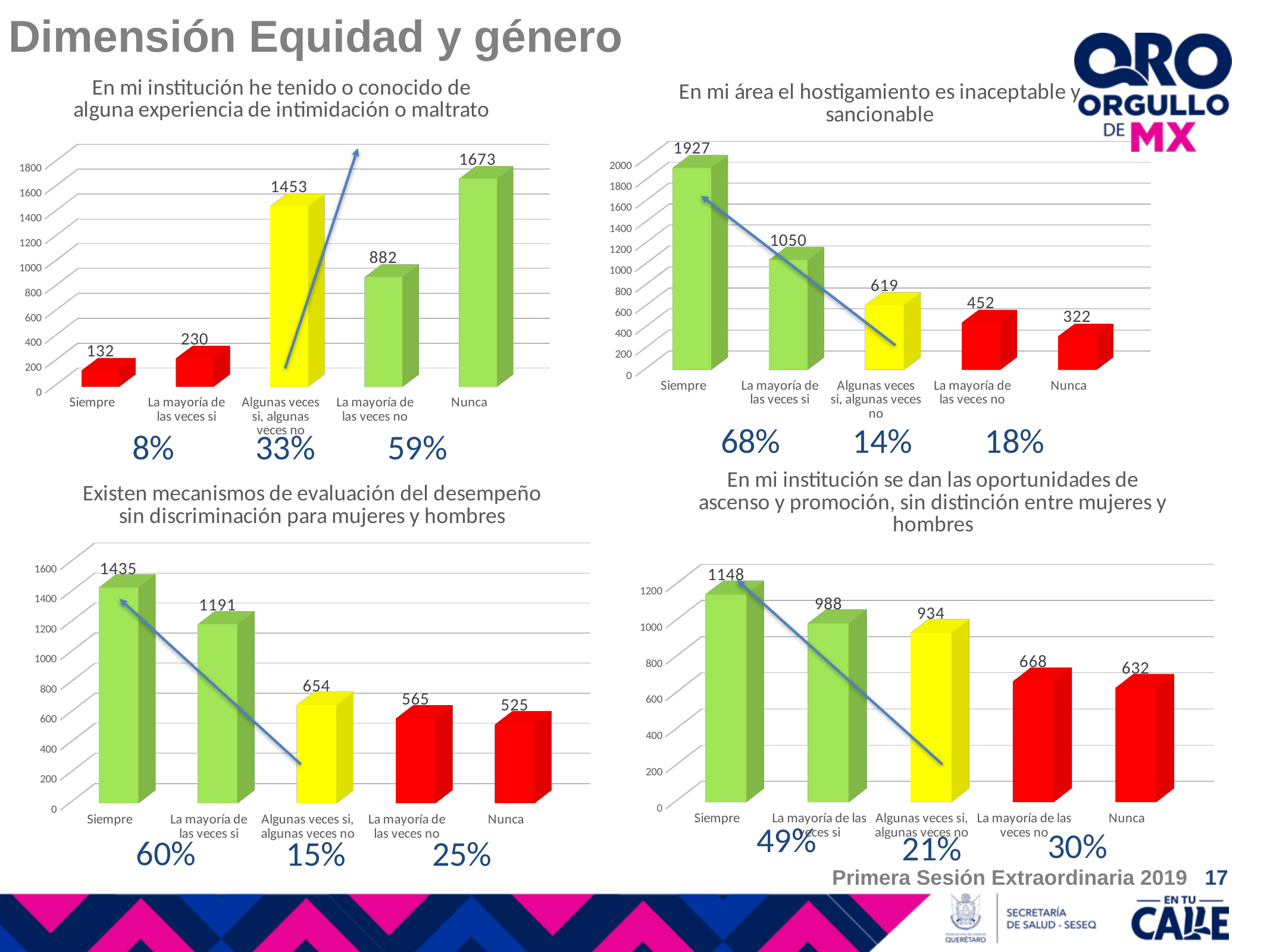
What kind of chart is the one titled 'En mi institución se dan las oportunidades de ascenso y promoción, sin distinción entre mujeres y hombres'? bar chart In the chart titled 'En mi área el hostigamiento es inaceptable y sancionable', which category has the highest value? Siempre In the chart titled 'Existen mecanismos de evaluación del desempeño sin discriminación para mujeres y hombres', which is larger, 'La mayoría de las veces no' or 'Nunca'? La mayoría de las veces no In the chart titled 'Existen mecanismos de evaluación del desempeño sin discriminación para mujeres y hombres', how many categories are shown on the x axis? 5 In the chart titled 'En mi institución he tenido o conocido de alguna experiencia de intimidación o maltrato', what is the value for 'Nunca'? 1673 In the chart titled 'Existen mecanismos de evaluación del desempeño sin discriminación para mujeres y hombres', what is the value for 'Algunas veces si, algunas veces no'? 654 In the chart titled 'En mi institución se dan las oportunidades de ascenso y promoción, sin distinción entre mujeres y hombres', what is the value for 'La mayoría de las veces si'? 988 In the chart titled 'En mi institución se dan las oportunidades de ascenso y promoción, sin distinción entre mujeres y hombres', what is the difference between 'Siempre' and 'Nunca'? 516 In the chart titled 'En mi institución he tenido o conocido de alguna experiencia de intimidación o maltrato', what is the difference between 'Nunca' and 'Algunas veces si, algunas veces no'? 220 In the chart titled 'En mi institución he tenido o conocido de alguna experiencia de intimidación o maltrato', which category has the lowest value? Siempre In the chart titled 'En mi área el hostigamiento es inaceptable y sancionable', do the values rise or fall from left to right along the x axis? fall In the chart titled 'En mi área el hostigamiento es inaceptable y sancionable', what is the value for 'Siempre'? 1927